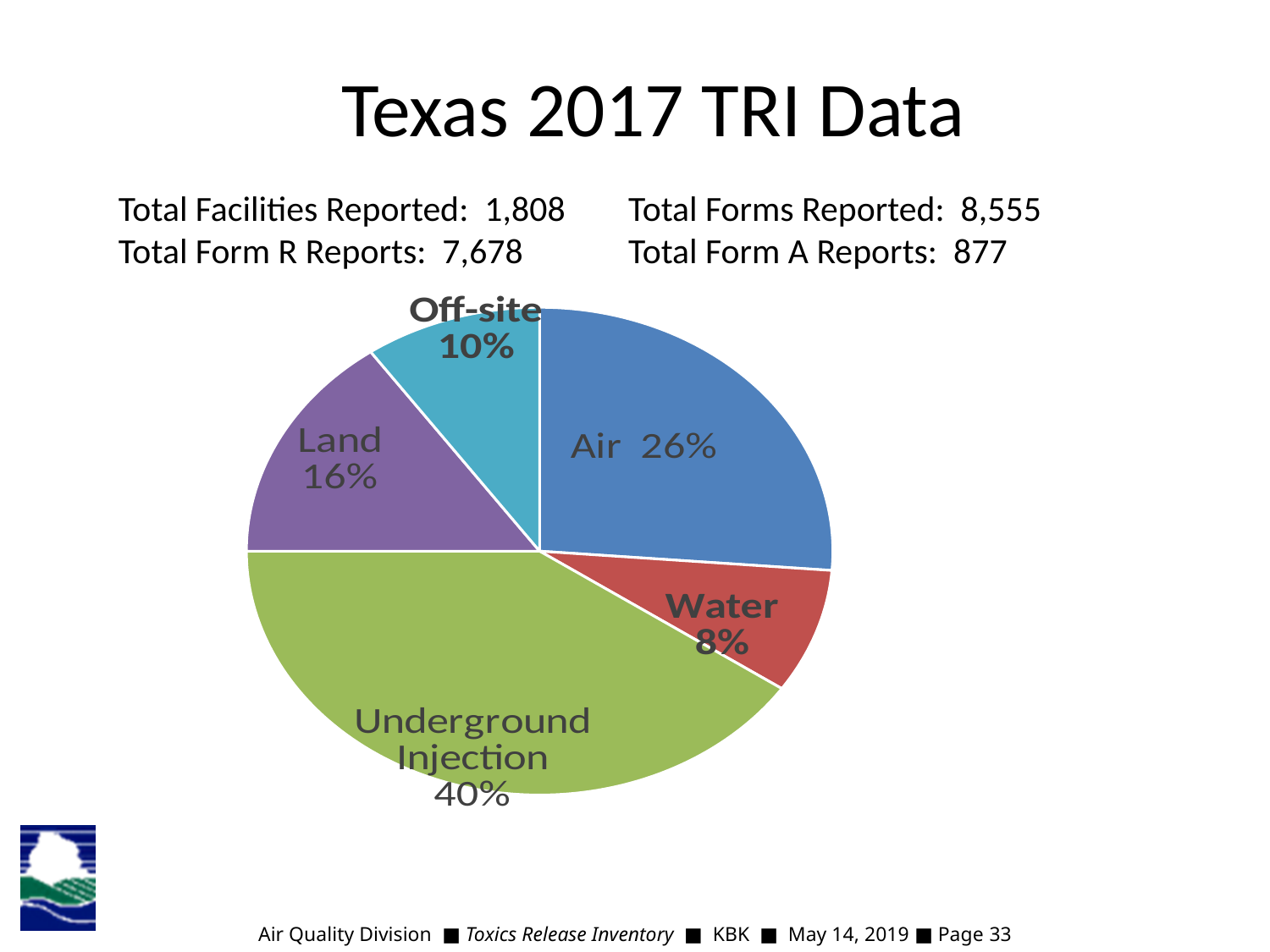
How many slices does the pie chart have? 5 Which slice is larger, Off-site or Land? Land What is the difference in percentage points between the Air and Land slices? 10 What share of the pie does Underground Injection represent? 40% What share of the pie does Land represent? 16% Which category has the largest slice of the pie? Underground Injection What kind of chart is shown on the slide? pie chart Which category has the smallest slice of the pie? Water What share of the pie does Water represent? 8% What is the title of the slide containing the pie chart? Texas 2017 TRI Data